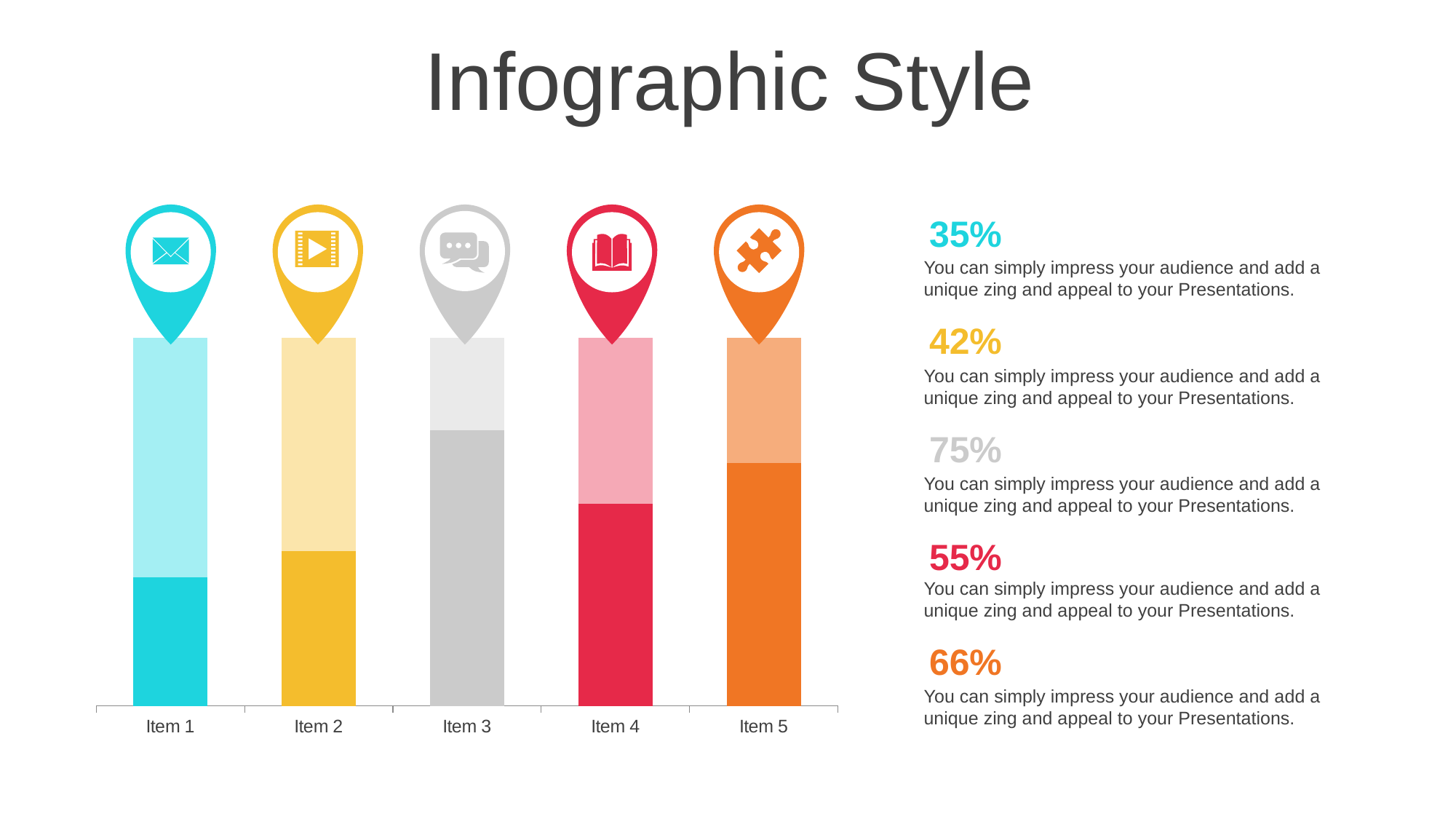
What percentage is shown for Item 4 (the red bar)? 55% What is the difference between the percentages for Item 3 and Item 1? 40 percentage points What percentage is shown for Item 2 (the yellow bar)? 42% What type of chart is shown on the slide? bar chart Which item has the highest filled value? Item 3 What percentage is shown for Item 3 (the grey bar)? 75% Which has the larger filled value, Item 4 or Item 5? Item 5 Which item has the lowest filled value? Item 1 What percentage is shown for Item 1 (the cyan bar)? 35% How many items (categories) are shown in the chart? 5 What is the title of the slide? Infographic Style What percentage is shown for Item 5 (the orange bar)? 66%